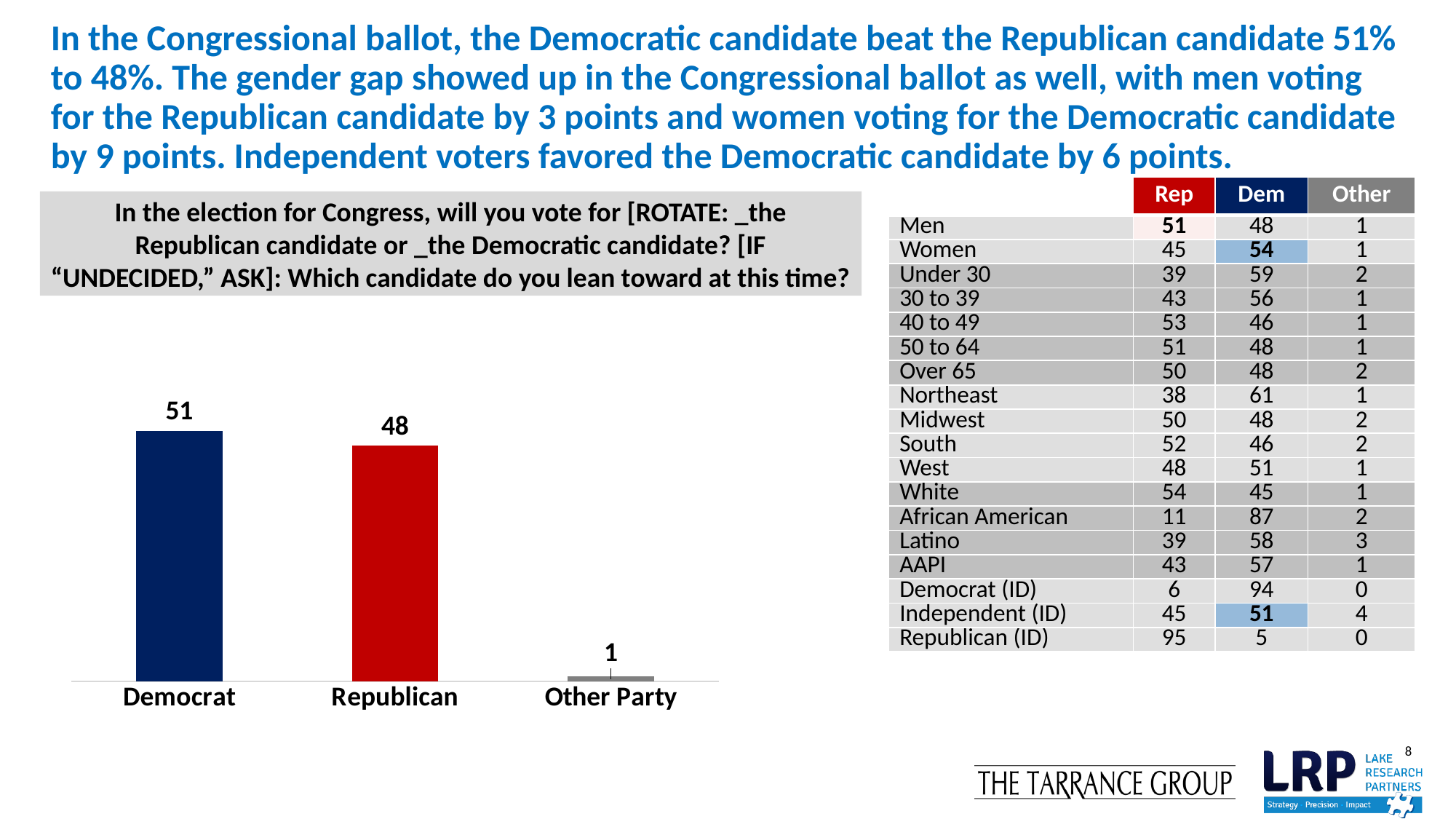
How many categories are shown in the bar chart? 3 What is the difference between the Democrat and Republican values in the bar chart? 3 What colour is the Democrat bar in the chart? Dark blue Which category has the highest value in the bar chart? Democrat Which category has the lowest value in the bar chart? Other Party What is the value shown for Other Party in the bar chart? 1 What kind of chart is shown on the slide? Bar chart What is the value shown for Republican in the bar chart? 48 What is the difference between the Republican and Other Party values in the bar chart? 47 What colour is the Republican bar in the chart? Red Which is larger in the bar chart, the value for Democrat or the value for Republican? Democrat What is the value shown for Democrat in the bar chart? 51